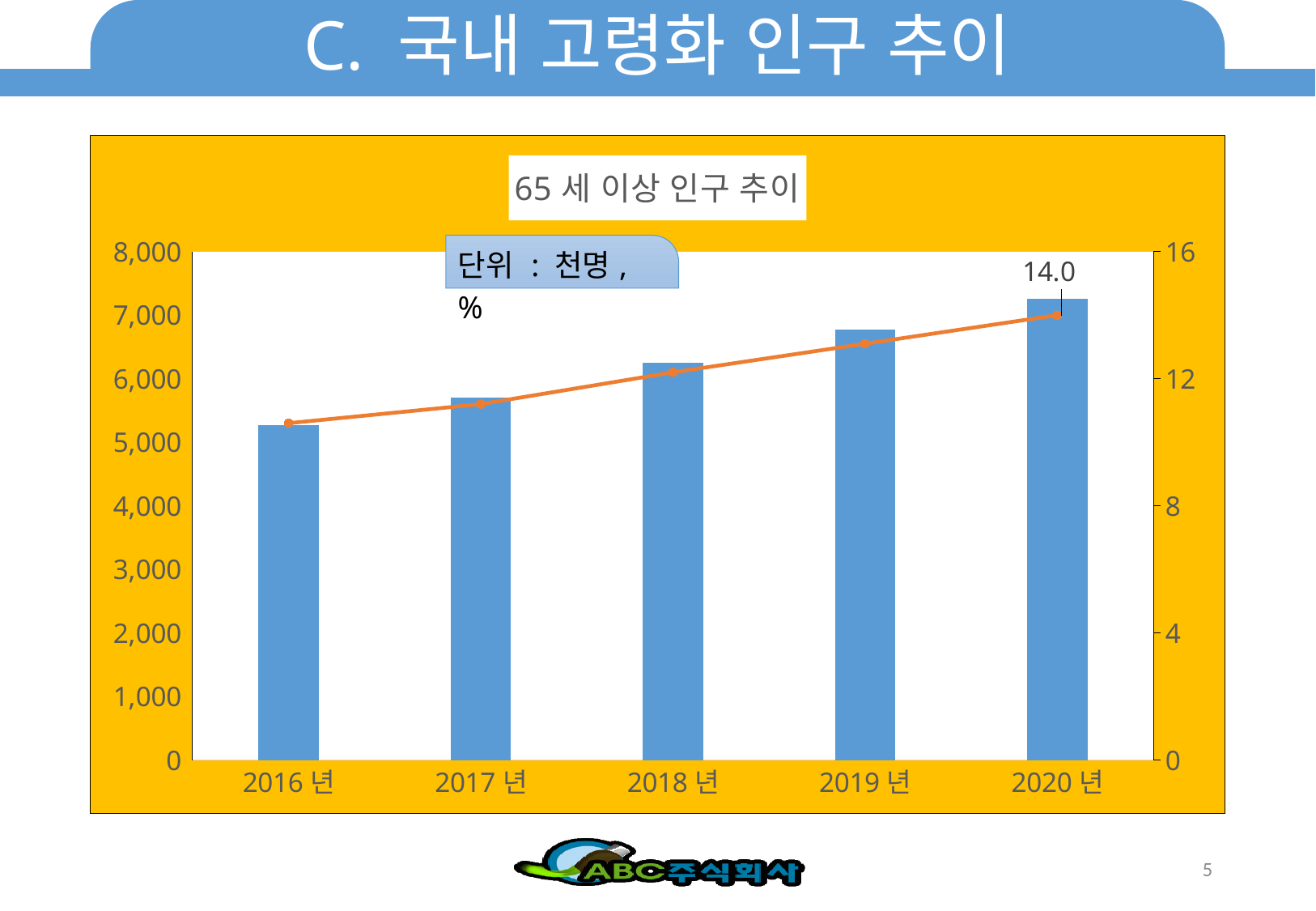
Is the bar value for 2020 년 greater or less than 7,000? greater Is the bar value for 2018 년 greater or less than 6,000? greater What kind of chart is this? bar chart with a line Is the bar value for 2019 년 greater or less than 7,000? less Which year has the shortest bar? 2016 년 Which year has the tallest bar? 2020 년 Do the bar values rise or fall from 2016 년 to 2020 년? rise Which bar is taller, 2017 년 or 2019 년? 2019 년 What is the data label shown on the line for 2020 년? 14.0 How many years are shown on the x axis? 5 What is the title of the chart? 65 세 이상 인구 추이